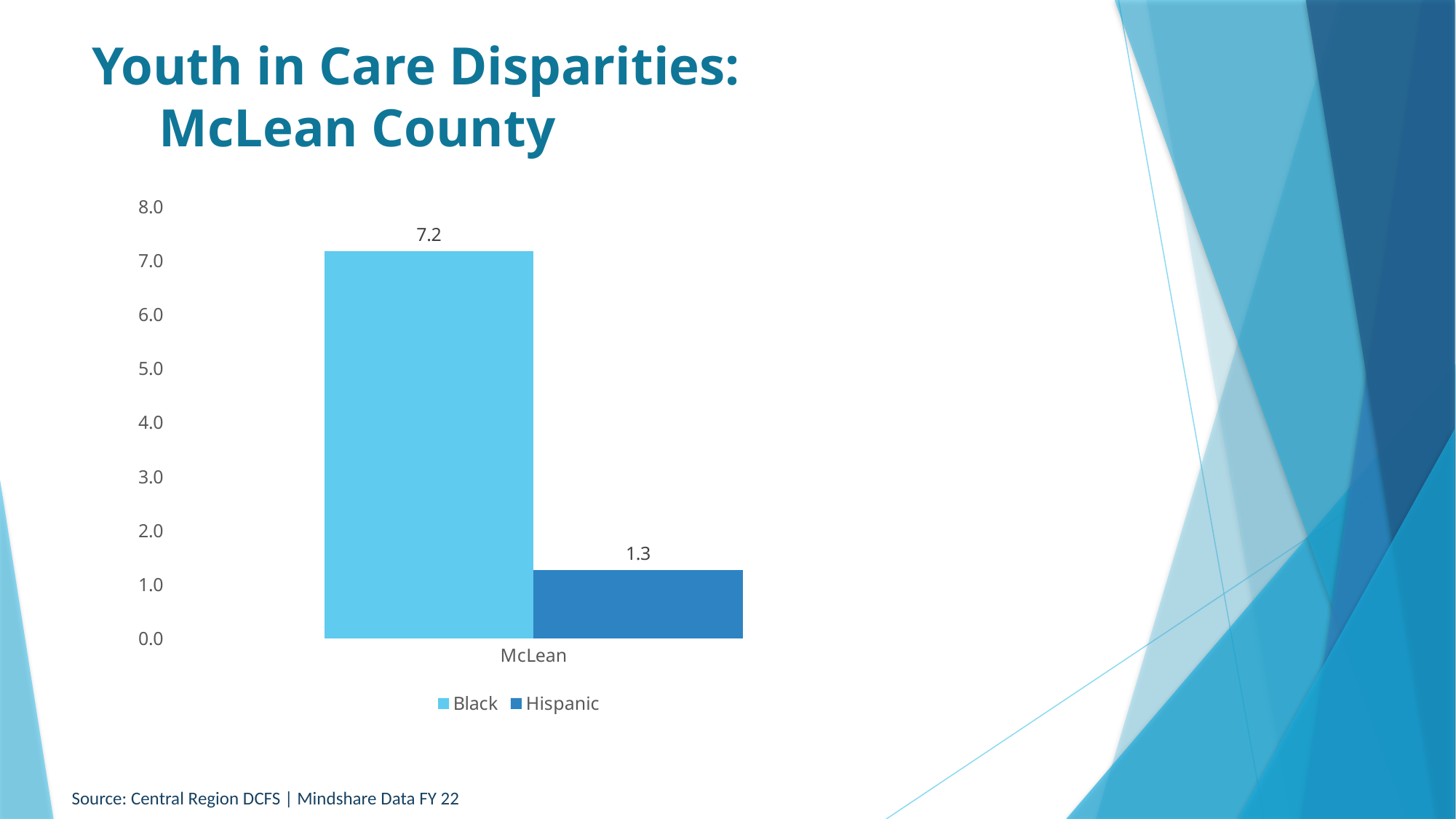
Which series has the higher value for McLean, Black or Hispanic? Black What kind of chart is shown on the slide? Bar chart What is the value for Hispanic in McLean? 1.3 Is the value for Hispanic in McLean greater or less than 2.0? less How many series does the legend list? 2 What is the value for Black in McLean? 7.2 What is the highest value shown on the y axis? 8.0 Is the value for Black in McLean greater or less than 6.0? greater Which series has the highest value in the chart? Black What is the difference between the Black and Hispanic values for McLean? 5.9 Which series has the lowest value in the chart? Hispanic How many categories are shown on the x axis? 1